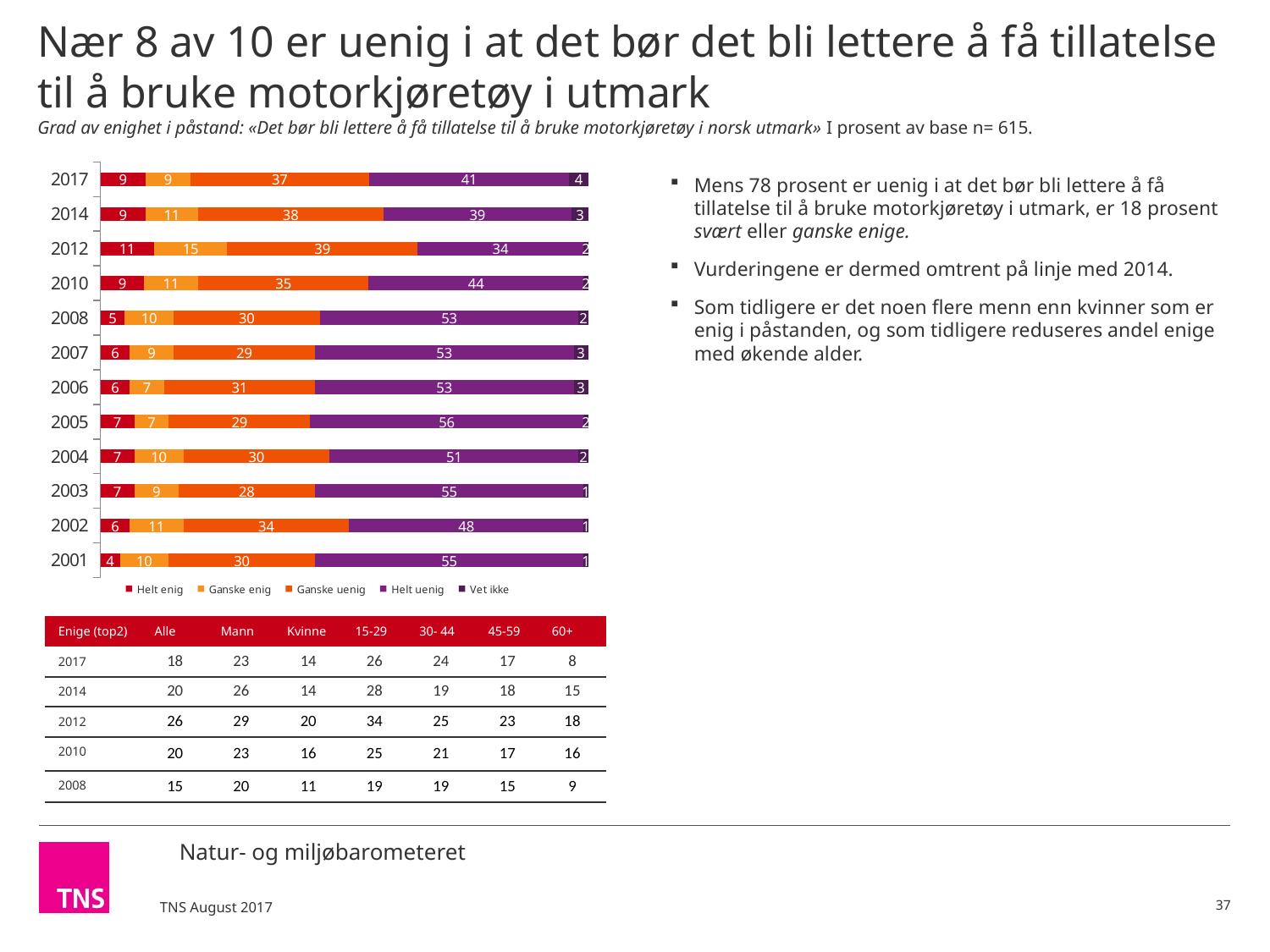
What is the value of Ganske uenig for 2012? 39 Which year has the highest value for Helt uenig? 2005 What is the difference between the Helt uenig values for 2010 and 2017? 3 What is the value of Helt enig for 2008? 5 How many series does the legend list? 5 Which year has the highest value for Helt enig? 2012 What is the value of Helt uenig for 2017? 41 What kind of chart is shown on the slide? Stacked bar chart What is the value of Vet ikke for 2014? 3 Which is larger, the Ganske enig value for 2012 or for 2014? 2012 Which year has the lowest value for Helt uenig? 2012 How many years are shown in the chart? 12